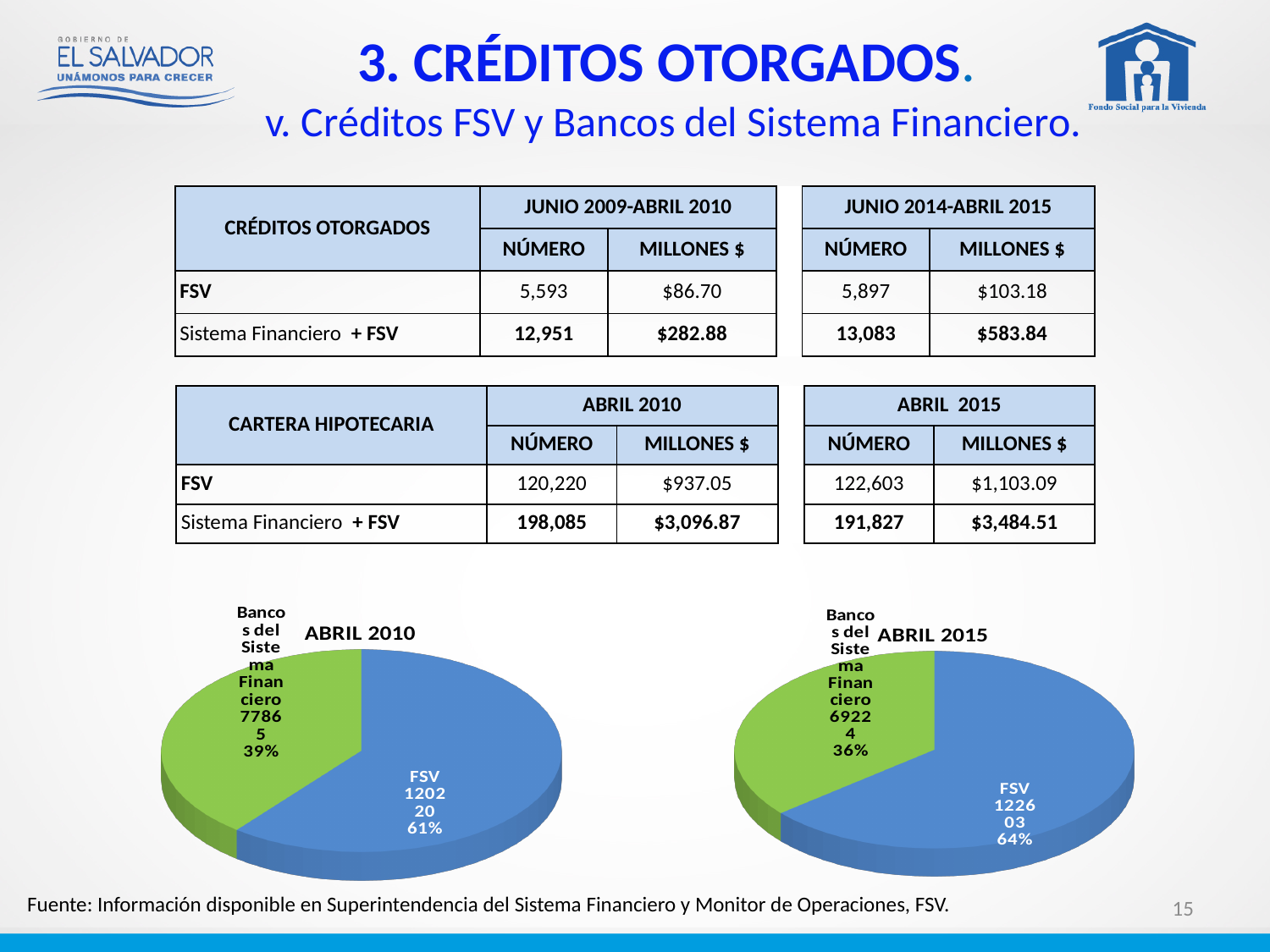
In the ABRIL 2015 pie chart, what share does FSV have? 64% What kind of chart is the ABRIL 2010 chart? pie chart In the ABRIL 2015 pie chart, which slice is the largest? FSV In the ABRIL 2015 pie chart, what colour is the FSV slice? blue How many slices does the ABRIL 2015 pie chart have? 2 In the ABRIL 2015 pie chart, what share do Bancos del Sistema Financiero have? 36% In the ABRIL 2010 pie chart, what is the difference between the FSV value and the Bancos del Sistema Financiero value? 42355 In the ABRIL 2010 pie chart, what share does FSV have? 61% In the ABRIL 2010 pie chart, which slice is the smallest? Bancos del Sistema Financiero In the ABRIL 2010 pie chart, what is the value shown for FSV? 120220 In the ABRIL 2015 pie chart, what is the value shown for Bancos del Sistema Financiero? 69224